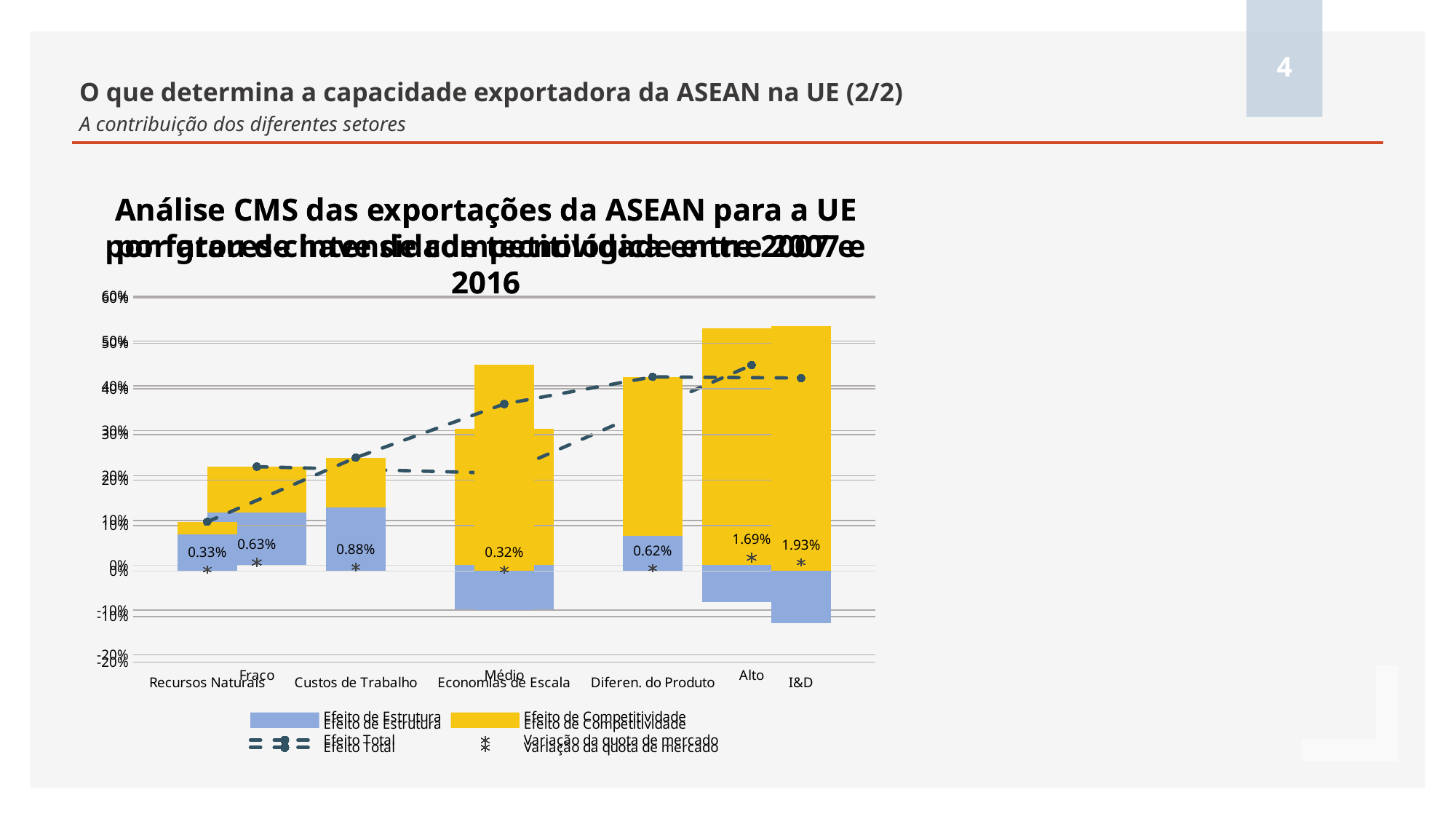
Does the Efeito Total dashed line rise or fall from Fraco to Alto? Rise What is the difference between the Variação da quota de mercado labels for I&D and Alto? 0.24% What is the Variação da quota de mercado value labelled for Fraco? 0.63% Which has the larger Variação da quota de mercado label, Alto or Fraco? Alto What kind of chart is used for the Efeito de Estrutura and Efeito de Competitividade series? Stacked bar chart Is the Efeito de Estrutura value for I&D greater or less than 0%? less What is the Variação da quota de mercado value labelled for Recursos Naturais? 0.33% Is the top of the stacked bar for I&D greater or less than 50%? greater What is the Variação da quota de mercado value labelled for Alto? 1.69% What is the Variação da quota de mercado value labelled for Custos de Trabalho? 0.88% What is the Variação da quota de mercado value labelled for I&D? 1.93% How many entries does the chart legend list? 4